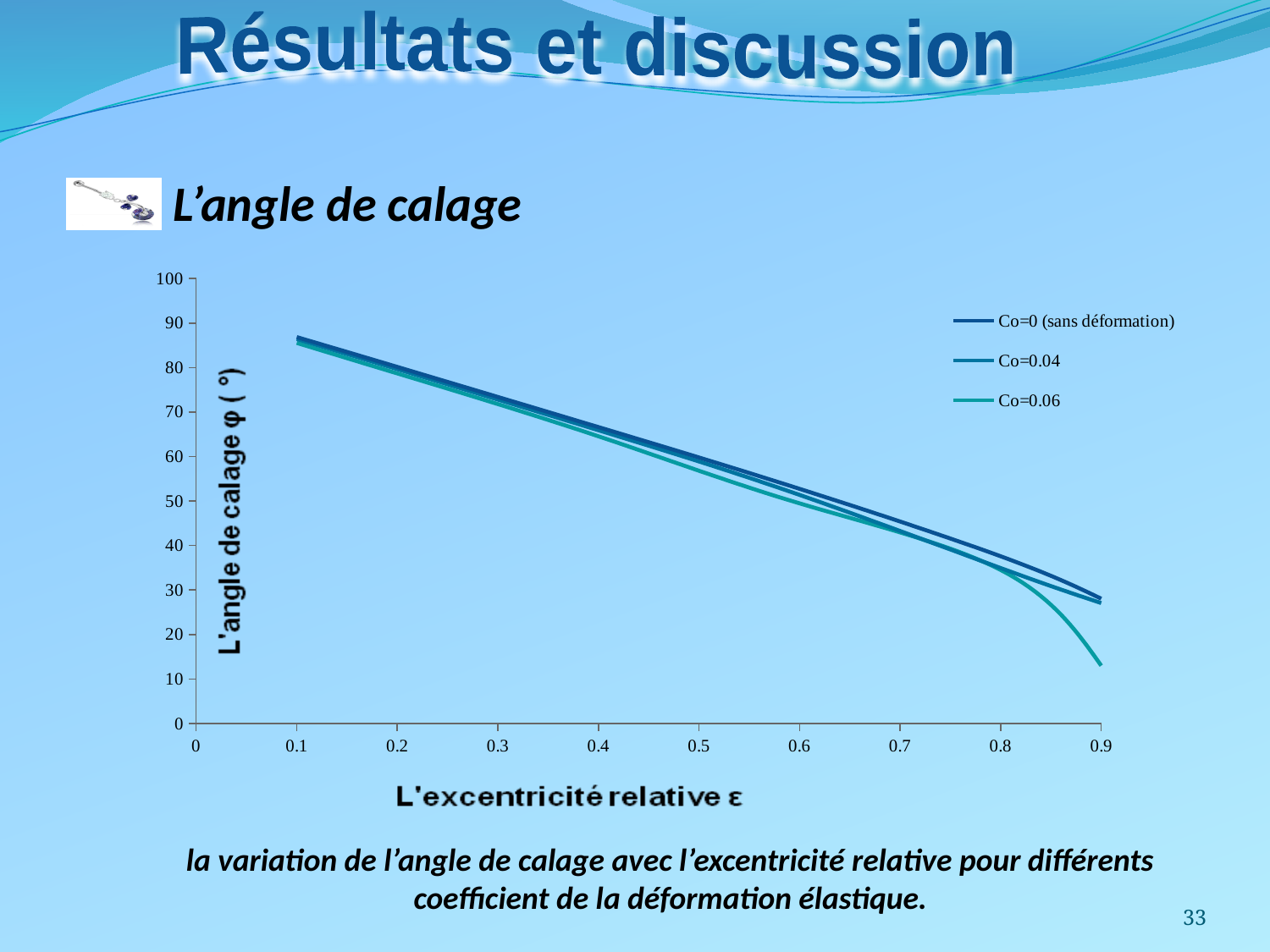
What kind of chart is shown on the slide? line chart Do the values of the Co=0 (sans déformation) series rise or fall as the relative eccentricity increases? fall How many series does the legend list? 3 Which series has the lowest value at ε = 0.9? Co=0.06 At ε = 0.1, is the value for Co=0.04 greater or less than 80? greater At ε = 0.9, is the value for Co=0.06 greater or less than 20? less Do the values of the Co=0.06 series rise or fall along the x axis? fall At ε = 0.9, is the value for Co=0 (sans déformation) greater or less than 20? greater At ε = 0.9, which is larger: the value for Co=0 (sans déformation) or the value for Co=0.06? Co=0 (sans déformation) What are the three series named in the legend? Co=0 (sans déformation), Co=0.04, Co=0.06 What is the title of the x axis? L'excentricité relative ε